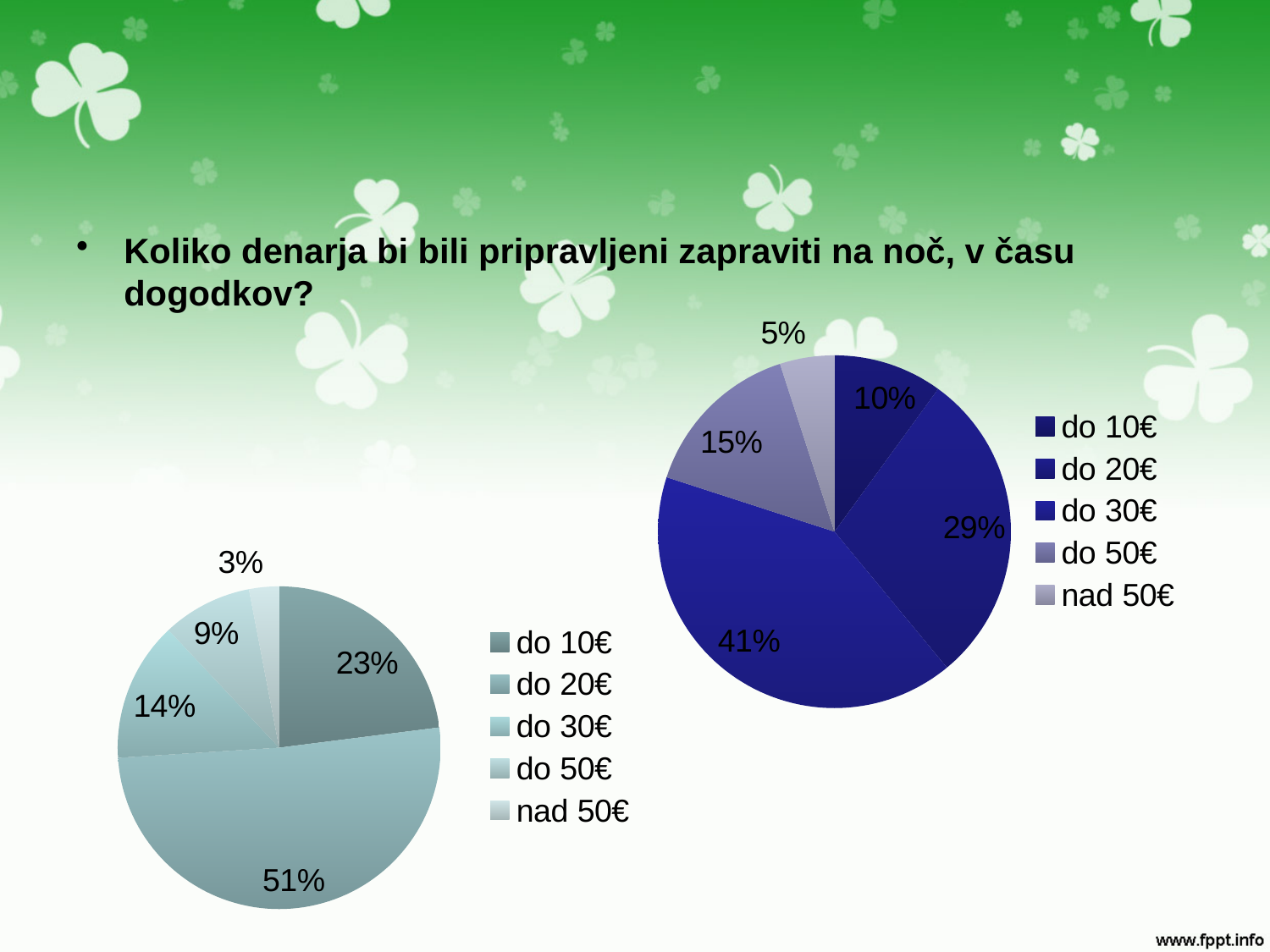
In the top-right pie chart, which is larger, 'do 20€' or 'do 50€'? do 20€ How many pie charts are shown on the slide? 2 In the bottom-left pie chart, which category has the smallest slice? nad 50€ In the top-right pie chart, what share does the 'nad 50€' slice have? 5% What kind of chart is the chart on the bottom left of the slide? pie chart In the top-right pie chart, which category has the largest slice? do 30€ In the bottom-left pie chart, what is the value for 'do 10€'? 23% In the top-right pie chart, what is the difference between the 'do 20€' and 'do 10€' slices? 19% In the top-right pie chart, what is the value for 'do 30€'? 41% In the bottom-left pie chart, what share does the 'do 20€' slice have? 51% How many categories does the legend of the bottom-left pie chart list? 5 In the bottom-left pie chart, what is the difference between the 'do 30€' and 'do 50€' slices? 5%